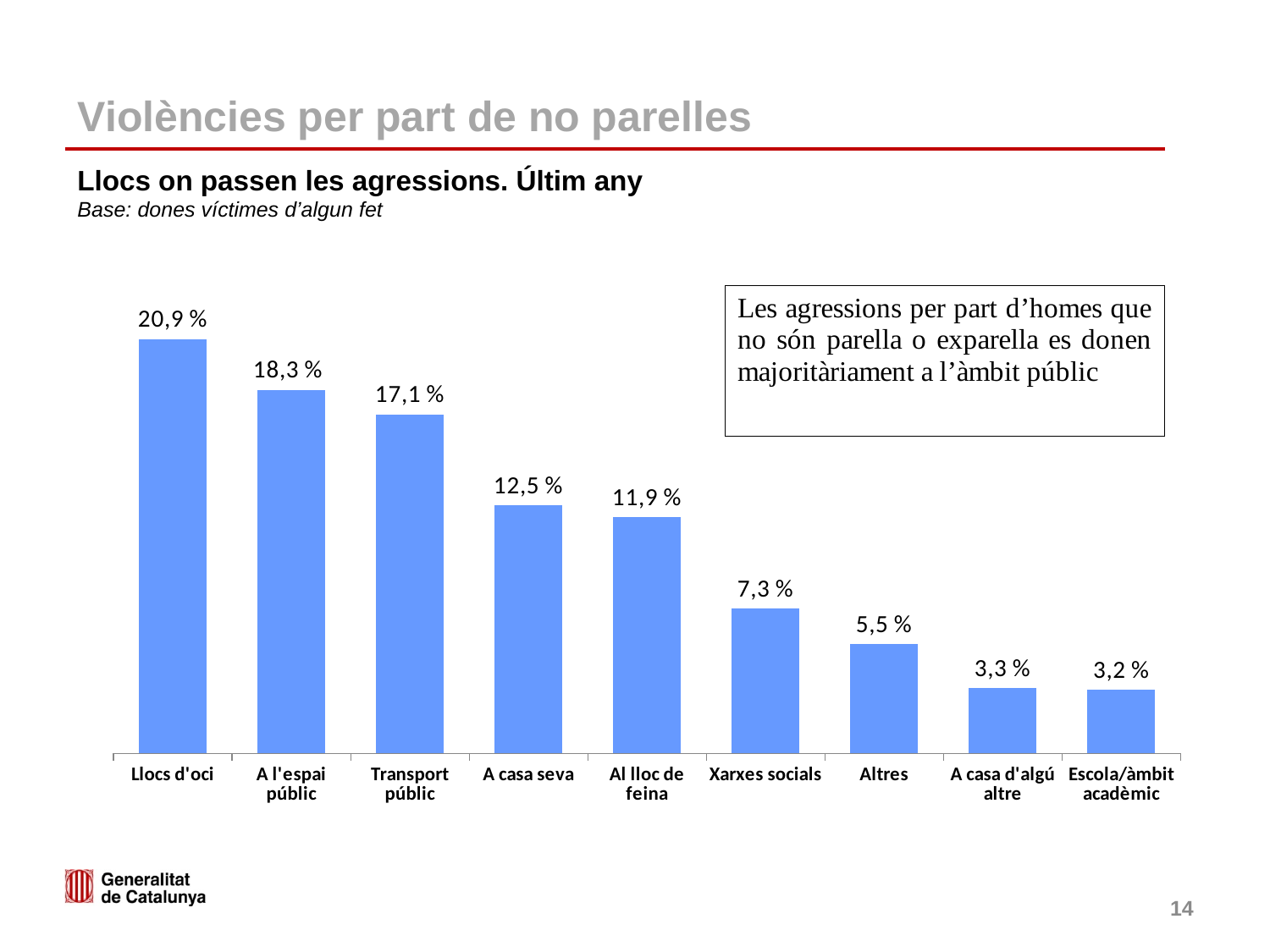
How many categories are shown in the chart? 9 What is the value for Transport públic? 17,1 % What is the difference between the values for Llocs d'oci and A l'espai públic? 2,6 % Do the values rise or fall from left to right along the x axis? Fall What is the difference between the values for A casa seva and Al lloc de feina? 0,6 % Which category has the highest value? Llocs d'oci What kind of chart is shown on the slide? Bar chart What is the value for Llocs d'oci? 20,9 % What is the value for Xarxes socials? 7,3 % What is the value for A casa d'algú altre? 3,3 % Which is larger, the value for Xarxes socials or the value for Altres? Xarxes socials Which category has the lowest value? Escola/àmbit acadèmic